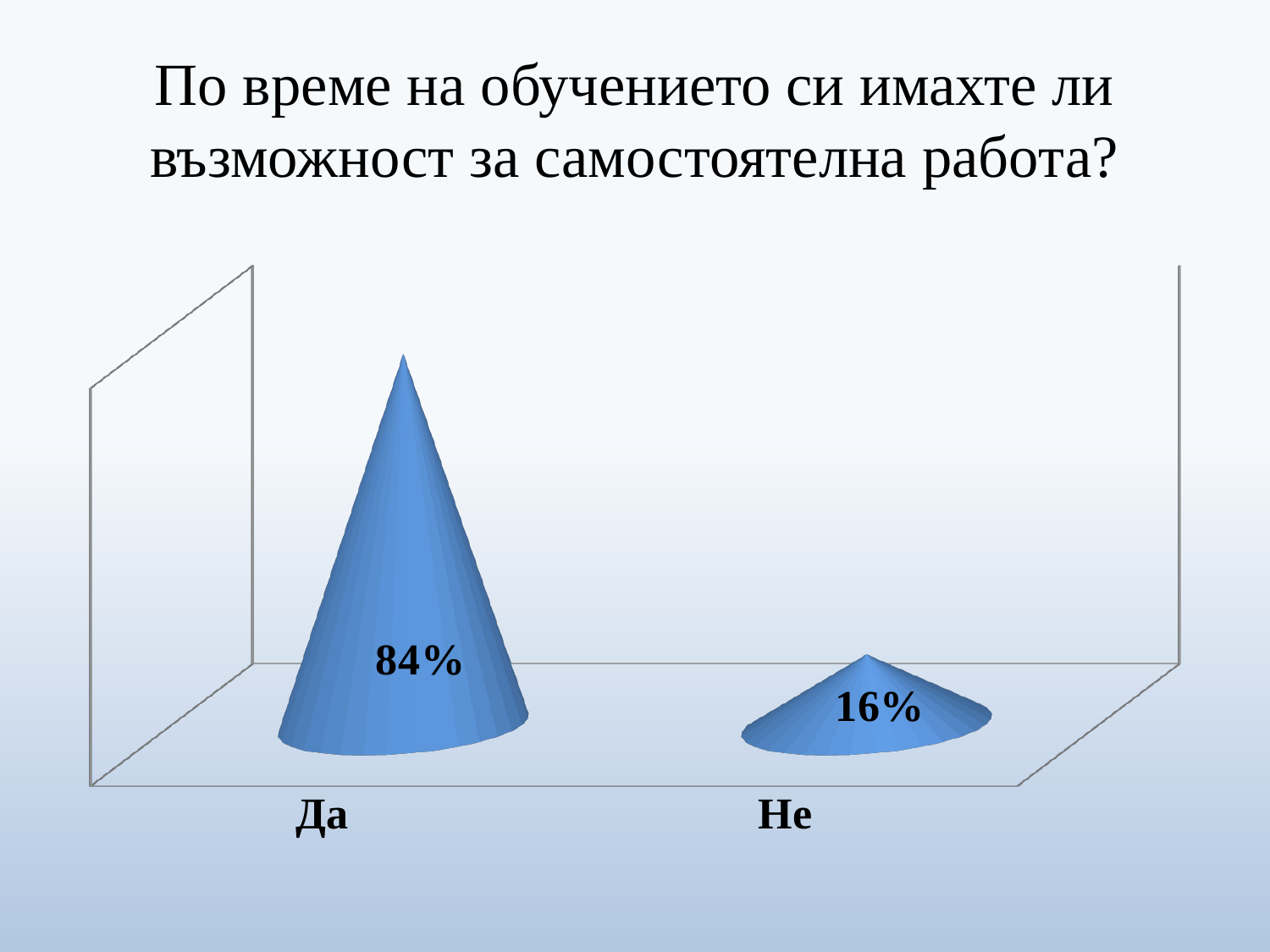
Which category has the lowest value? Не What is the value for Да? 84% What is the value for Не? 16% How many categories are shown in the chart? 2 Which category has the highest value? Да What kind of chart is shown on the slide? bar chart What is the title of the slide above the chart? По време на обучението си имахте ли възможност за самостоятелна работа? Which is larger, the value for Да or the value for Не? Да What colour are the bars in the chart? blue What is the difference between the values for Да and Не? 68% What is the total of the two values shown in the chart? 100%